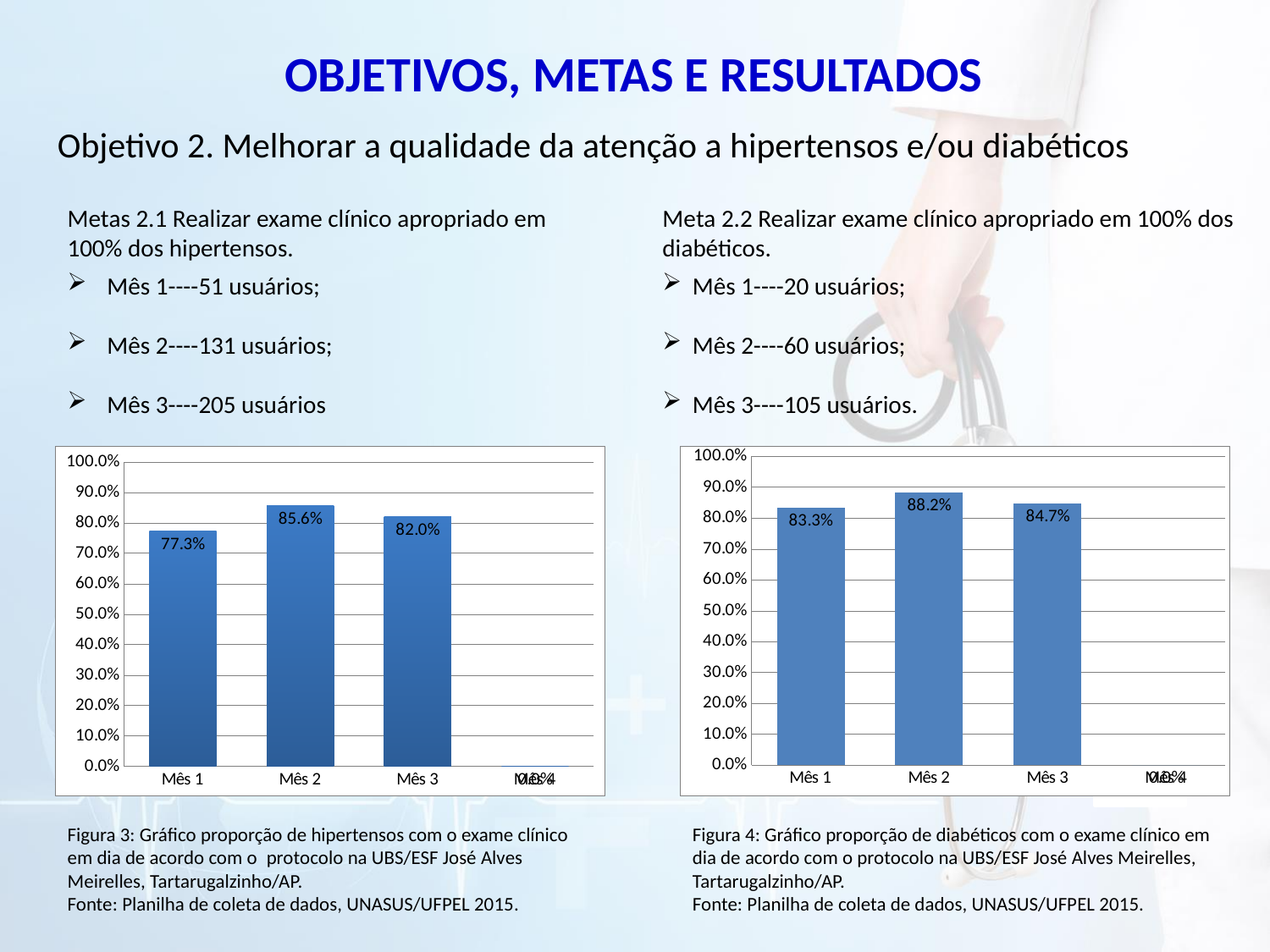
In the right chart (Figura 4, diabéticos), is the value for Mês 1 greater or less than 80.0%? greater In the left chart (Figura 3, hipertensos), which month has the highest value? Mês 2 In the right chart (Figura 4, diabéticos), what is the value for Mês 1? 83.3% In the right chart (Figura 4, diabéticos), what is the difference between the values for Mês 2 and Mês 3? 3.5% In the left chart (Figura 3, hipertensos), what is the value for Mês 1? 77.3% In the left chart (Figura 3, hipertensos), which is larger, the value for Mês 3 or the value for Mês 1? Mês 3 In the left chart (Figura 3, hipertensos), what is the value for Mês 2? 85.6% In the right chart (Figura 4, diabéticos), what is the value for Mês 3? 84.7% What kind of chart is the left chart (Figura 3)? Bar chart In the left chart (Figura 3, hipertensos), what is the difference between the values for Mês 2 and Mês 1? 8.3% In the right chart (Figura 4, diabéticos), which month has the highest value? Mês 2 In the left chart (Figura 3, hipertensos), does the value rise or fall from Mês 2 to Mês 3? Fall